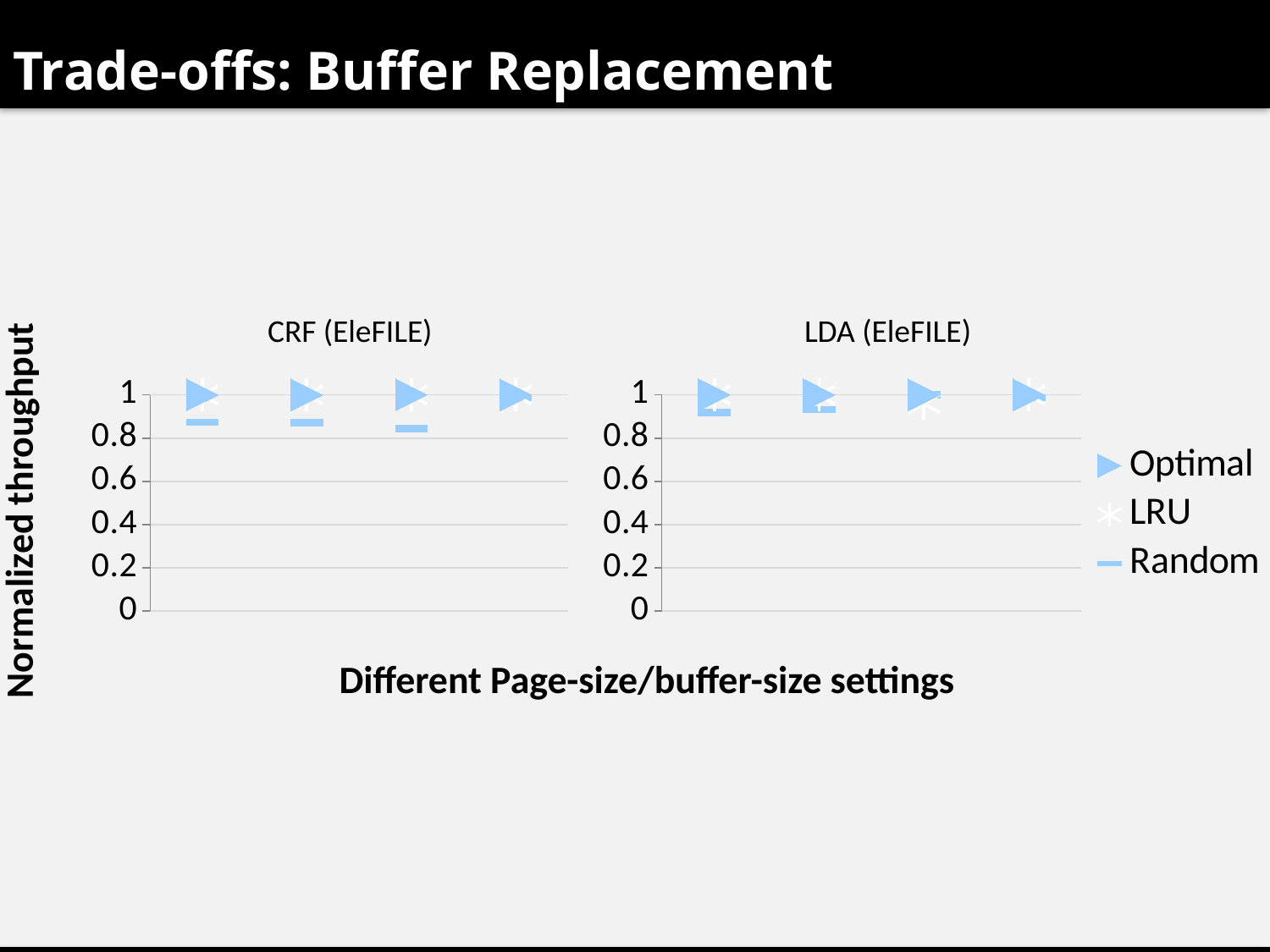
In the LDA (EleFILE) chart, is the value of the first Random point greater or less than 0.6? greater In the CRF (EleFILE) chart, is the value of the first Random point greater or less than 0.8? greater What kind of chart is the CRF (EleFILE) chart? scatter chart In the LDA (EleFILE) chart, is the value of the first Optimal point greater or less than 0.8? greater What is the title of the left chart? CRF (EleFILE) In the CRF (EleFILE) chart, which series has higher values, Optimal or Random? Optimal How many series does the legend list? 3 Which series are listed in the legend? Optimal, LRU, Random How many Optimal points are plotted in the LDA (EleFILE) chart? 4 How many Optimal points are plotted in the CRF (EleFILE) chart? 4